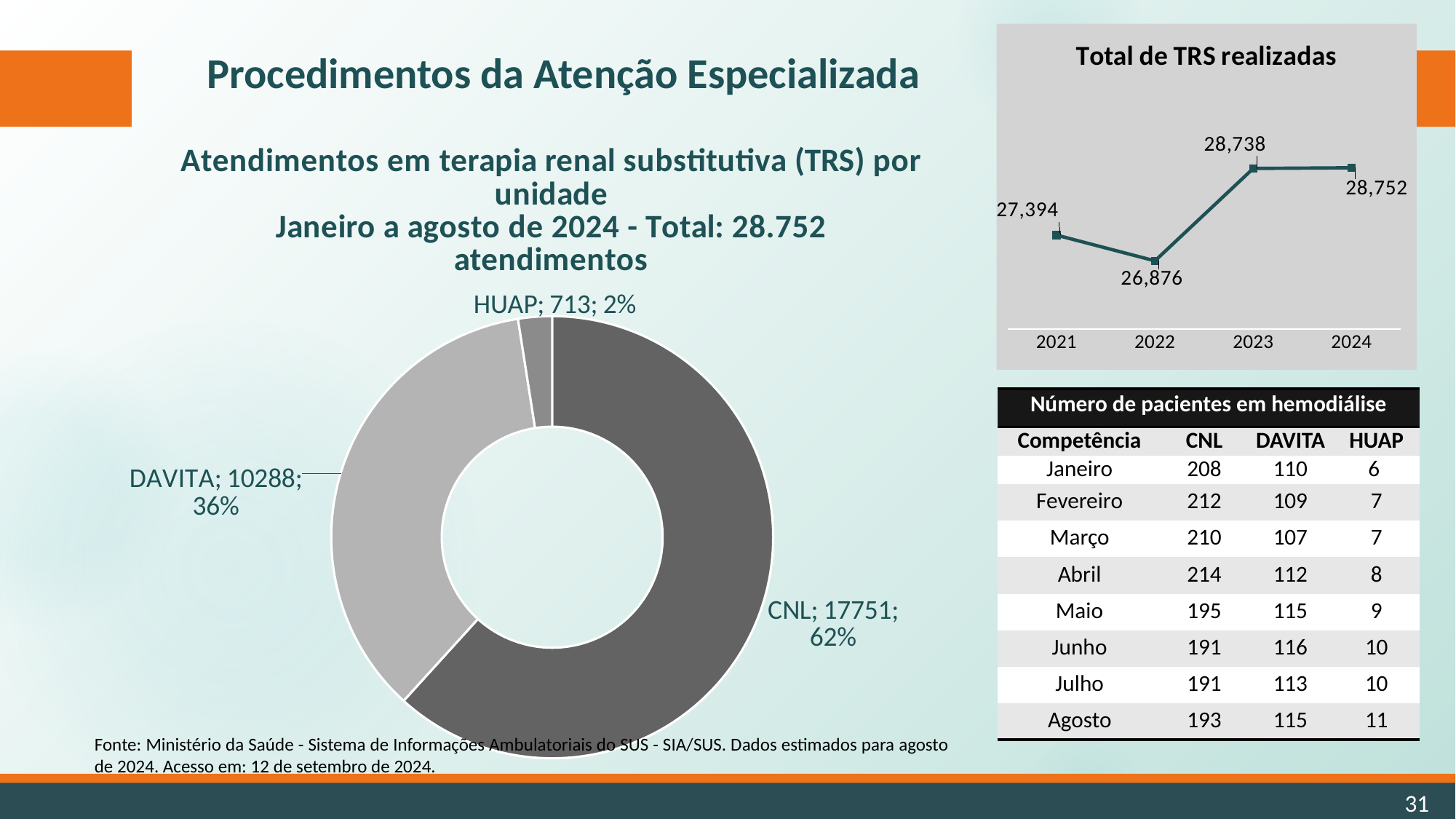
In the chart titled 'Total de TRS realizadas', which year has the lowest value? 2022 In the chart titled 'Total de TRS realizadas', how many years are plotted? 4 What kind of chart is the one titled 'Total de TRS realizadas'? line chart In the pie chart on the left, which unit has the largest number of atendimentos? CNL In the pie chart on the left, which unit has the smallest number of atendimentos? HUAP In the pie chart on the left, how many units (slices) are shown? 3 In the chart titled 'Total de TRS realizadas', which year has the highest value? 2024 In the chart titled 'Total de TRS realizadas', what is the difference between the 2023 and 2021 values? 1,344 In the pie chart on the left, what is the difference between the CNL and DAVITA values? 7463 In the pie chart on the left, what share of atendimentos does DAVITA represent? 36% In the pie chart on the left, how many atendimentos does CNL account for? 17751 In the chart titled 'Total de TRS realizadas', what is the value for 2022? 26,876